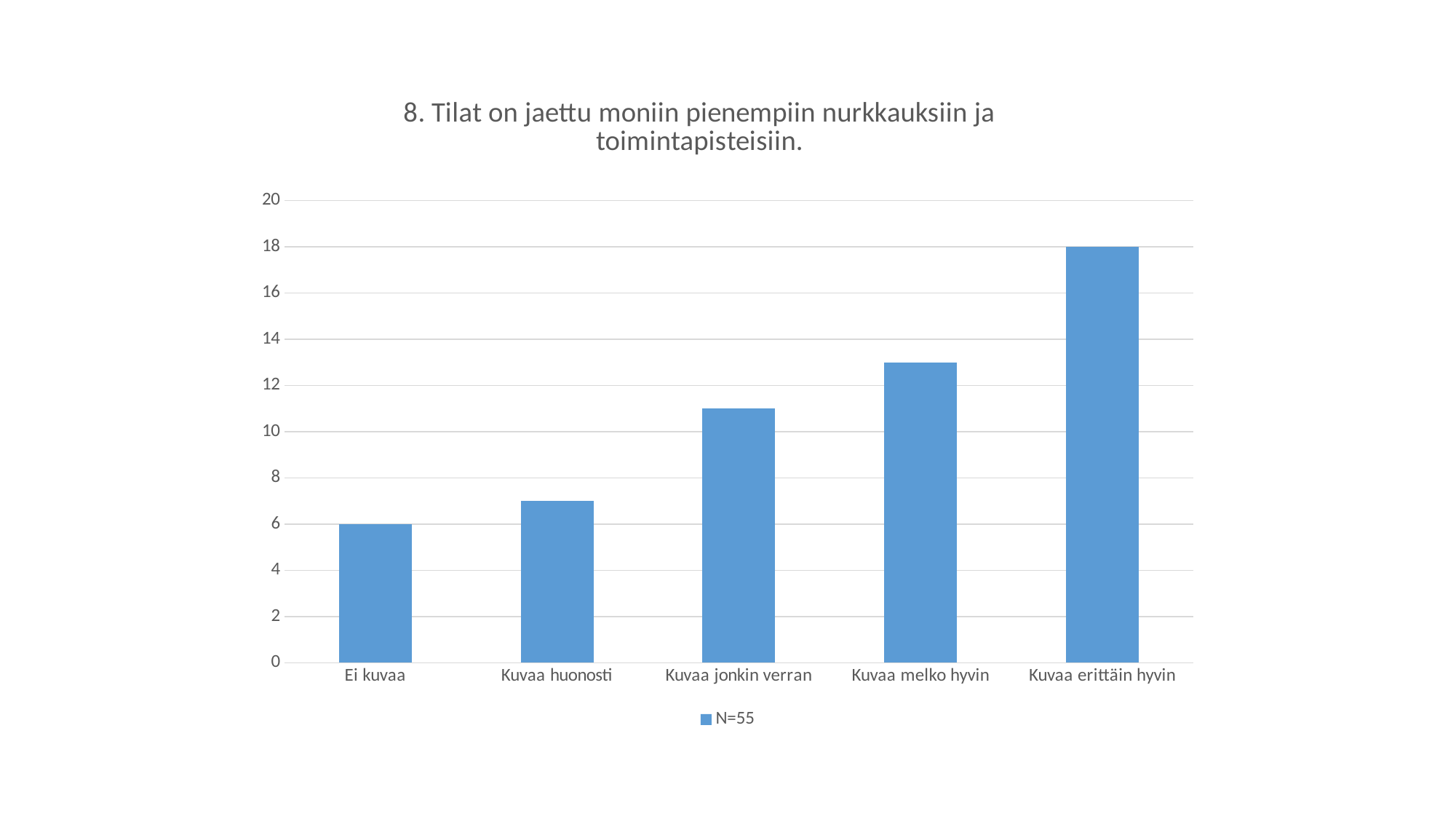
Is the value for Kuvaa melko hyvin greater or less than 14? less How many series does the legend list? 1 What is the difference between the values for Kuvaa erittäin hyvin and Ei kuvaa? 12 What is the legend entry for the series? N=55 Is the value for Kuvaa jonkin verran greater or less than 10? greater Which category has the lowest value? Ei kuvaa Do the values rise or fall from left to right along the x axis? rise What is the value for Ei kuvaa? 6 What type of chart is shown on the slide? bar chart Which category has the highest value? Kuvaa erittäin hyvin How many categories are shown on the x axis? 5 What is the value for Kuvaa erittäin hyvin? 18